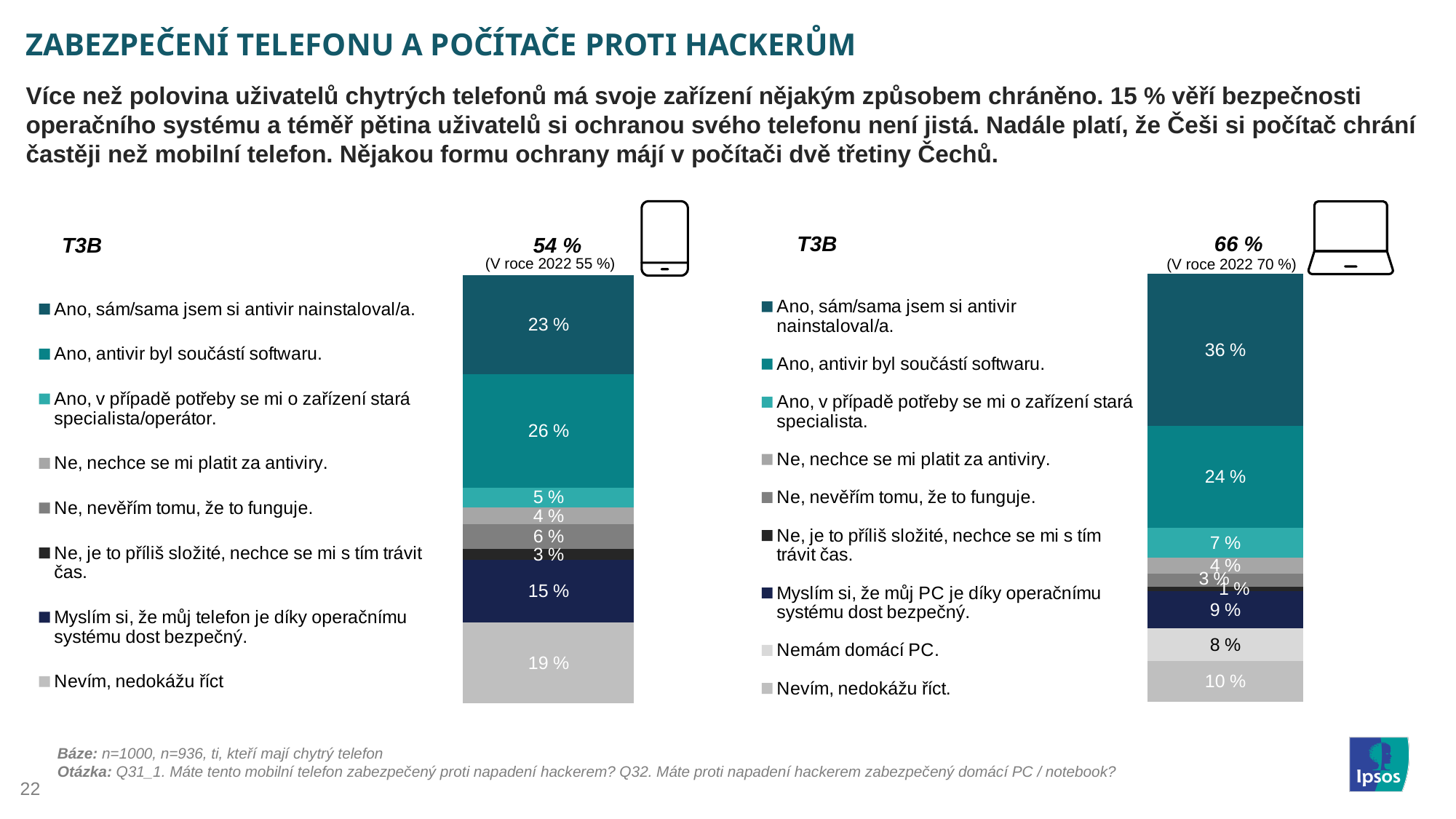
How many legend entries does the left chart (mobile phone) list? 8 In the left chart (mobile phone), which response has the largest share? Ano, antivir byl součástí softwaru. Which is larger: the share who think their device is secure thanks to the operating system in the left chart (mobile phone) or in the right chart (PC)? Left chart (mobile phone), 15 % In the right chart (PC), what percentage of respondents said they installed the antivirus themselves ("Ano, sám/sama jsem si antivir nainstaloval/a.")? 36 % In the left chart (mobile phone), what percentage of respondents said they installed the antivirus themselves ("Ano, sám/sama jsem si antivir nainstaloval/a.")? 23 % In the left chart (mobile phone), what percentage answered "Nevím, nedokážu říct"? 19 % In the right chart (PC), which response has the smallest share? Ne, je to příliš složité, nechce se mi s tím trávit čas. What is the difference between the share who installed antivirus themselves in the right chart (PC, 36 %) and in the left chart (mobile phone, 23 %)? 13 percentage points How many legend entries does the right chart (PC) list? 9 In the right chart (PC), what percentage answered "Nemám domácí PC."? 8 % What type of chart is used on this slide? Stacked bar chart What T3B value is shown above the right chart (PC)? 66 %